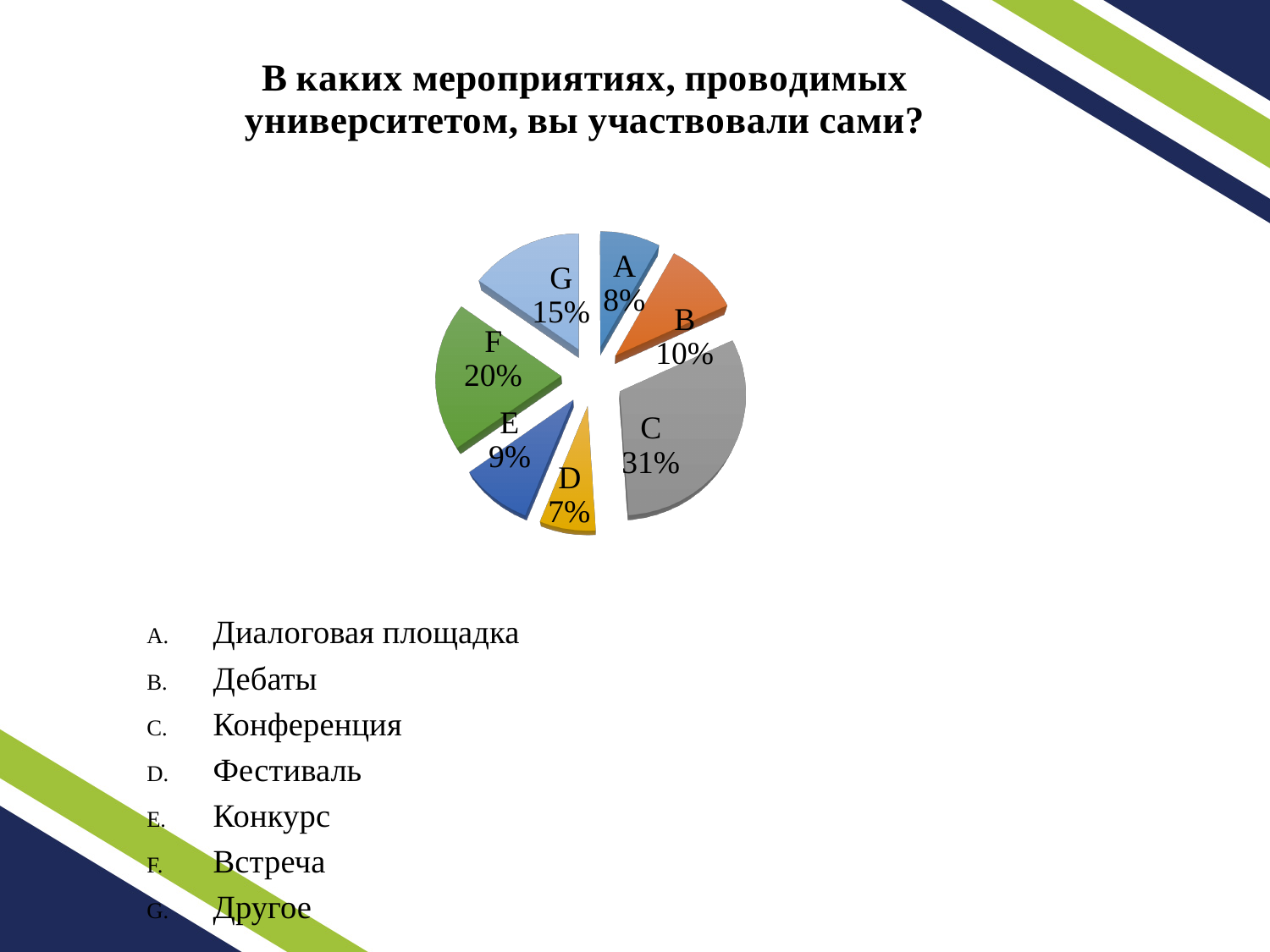
Which slice has the largest share of the pie? C Which is larger, the share of slice B or the share of slice E? B Which slice has the smallest share of the pie? D What is the value shown for slice G? 15% What is the value shown for slice F? 20% What kind of chart is shown on the slide? pie chart What is the combined share of slices A and B? 18% What is the value shown for slice D? 7% What share of the pie does slice C have? 31% What is the title of the question shown above the chart? В каких мероприятиях, проводимых университетом, вы участвовали сами? What is the difference between the shares of slice C and slice F? 11% How many slices does the pie chart have? 7